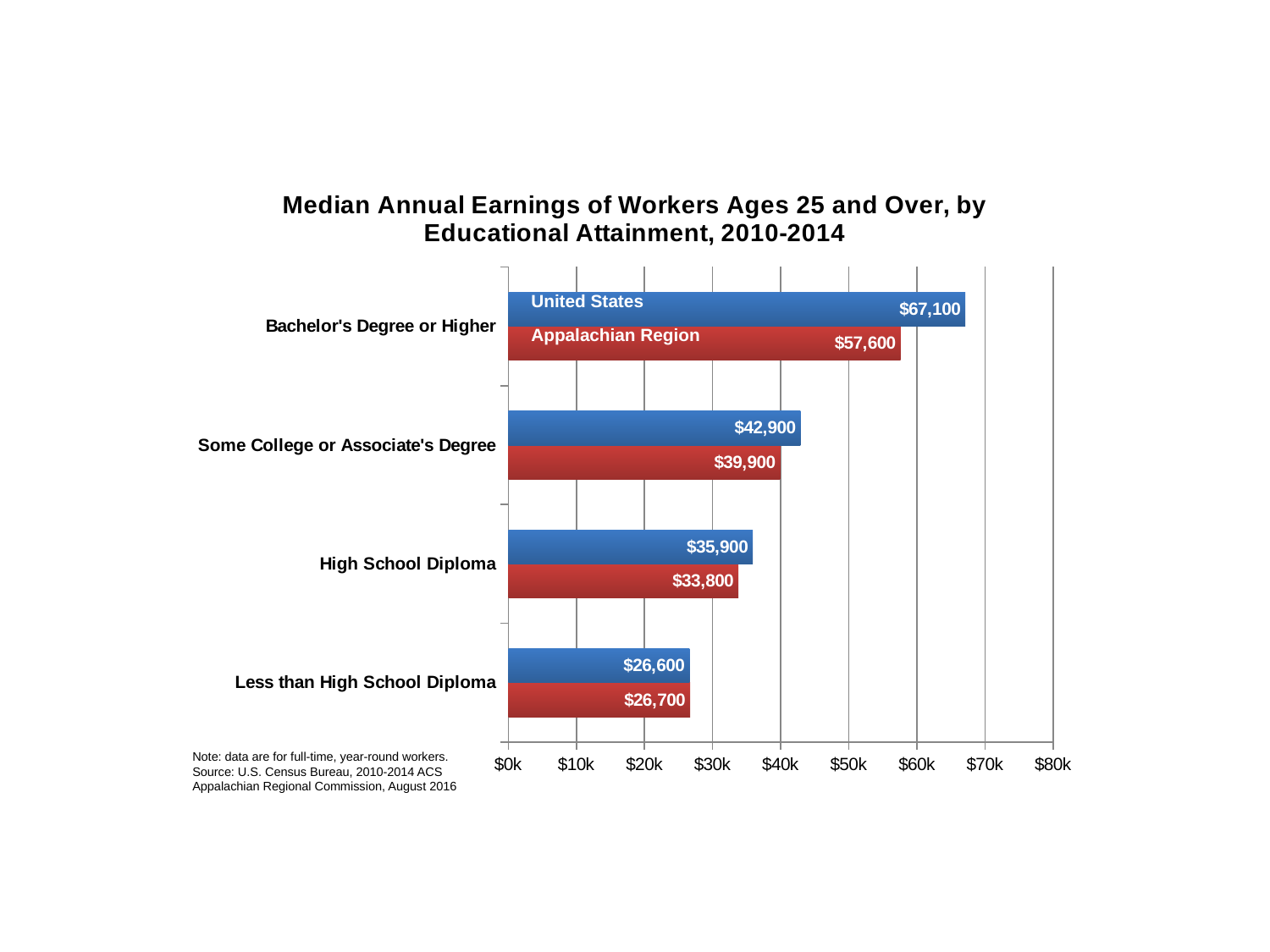
What is the median annual earnings for Appalachian Region workers with a High School Diploma? $33,800 What is the median annual earnings for United States workers with a Bachelor's Degree or Higher? $67,100 Which colour represents the Appalachian Region series? Red Which educational attainment category has the highest median annual earnings for the United States? Bachelor's Degree or Higher What is the difference between United States and Appalachian Region median earnings for workers with a High School Diploma? $2,100 What type of chart is shown on the slide? Bar chart Which is larger: United States median earnings for Some College or Associate's Degree, or Appalachian Region median earnings for Bachelor's Degree or Higher? Appalachian Region median earnings for Bachelor's Degree or Higher How many educational attainment categories are shown on the chart? 4 How many data series does the chart show? 2 What is the difference between United States and Appalachian Region median earnings for workers with a Bachelor's Degree or Higher? $9,500 Which educational attainment category has the lowest median annual earnings for the Appalachian Region? Less than High School Diploma What is the median annual earnings for Appalachian Region workers with Some College or Associate's Degree? $39,900